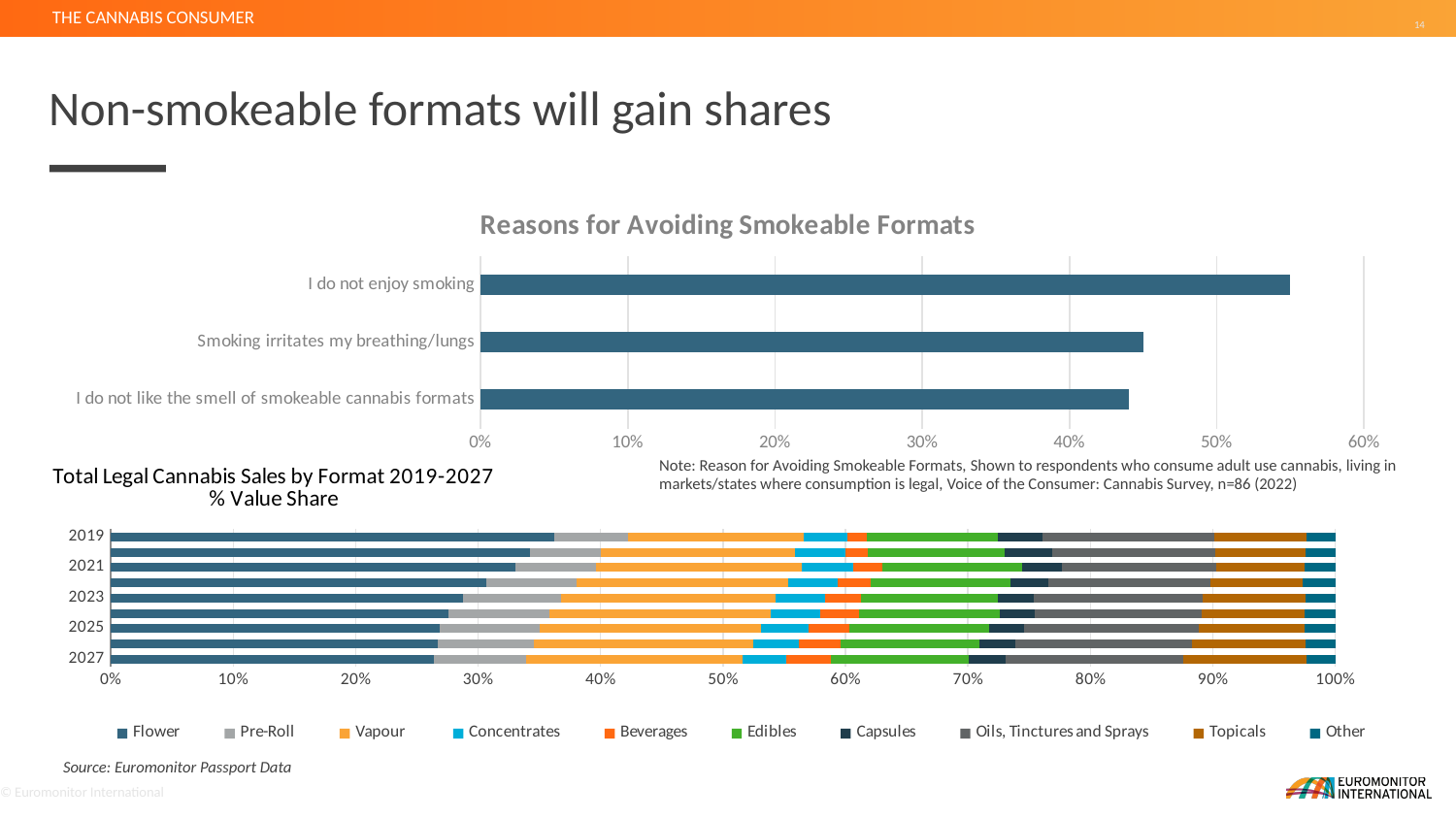
In the "Total Legal Cannabis Sales by Format 2019-2027" chart, does the Flower share rise or fall from 2019 to 2027? Fall In the "Reasons for Avoiding Smokeable Formats" chart, is the value for "Smoking irritates my breathing/lungs" greater or less than 40%? greater In the "Reasons for Avoiding Smokeable Formats" chart, which reason has the highest value? I do not enjoy smoking In the "Reasons for Avoiding Smokeable Formats" chart, is the value for "I do not like the smell of smokeable cannabis formats" greater or less than 50%? less In the "Total Legal Cannabis Sales by Format 2019-2027" chart, which series is listed first in the legend? Flower In the "Reasons for Avoiding Smokeable Formats" chart, which is larger: "I do not enjoy smoking" or "Smoking irritates my breathing/lungs"? I do not enjoy smoking In the "Total Legal Cannabis Sales by Format 2019-2027" chart, is the Flower share in 2019 greater or less than 30%? greater What type of chart is "Reasons for Avoiding Smokeable Formats"? Bar chart How many series does the legend of the "Total Legal Cannabis Sales by Format 2019-2027" chart list? 10 What type of chart is "Total Legal Cannabis Sales by Format 2019-2027 % Value Share"? Stacked bar chart In the "Reasons for Avoiding Smokeable Formats" chart, how many reasons are shown? 3